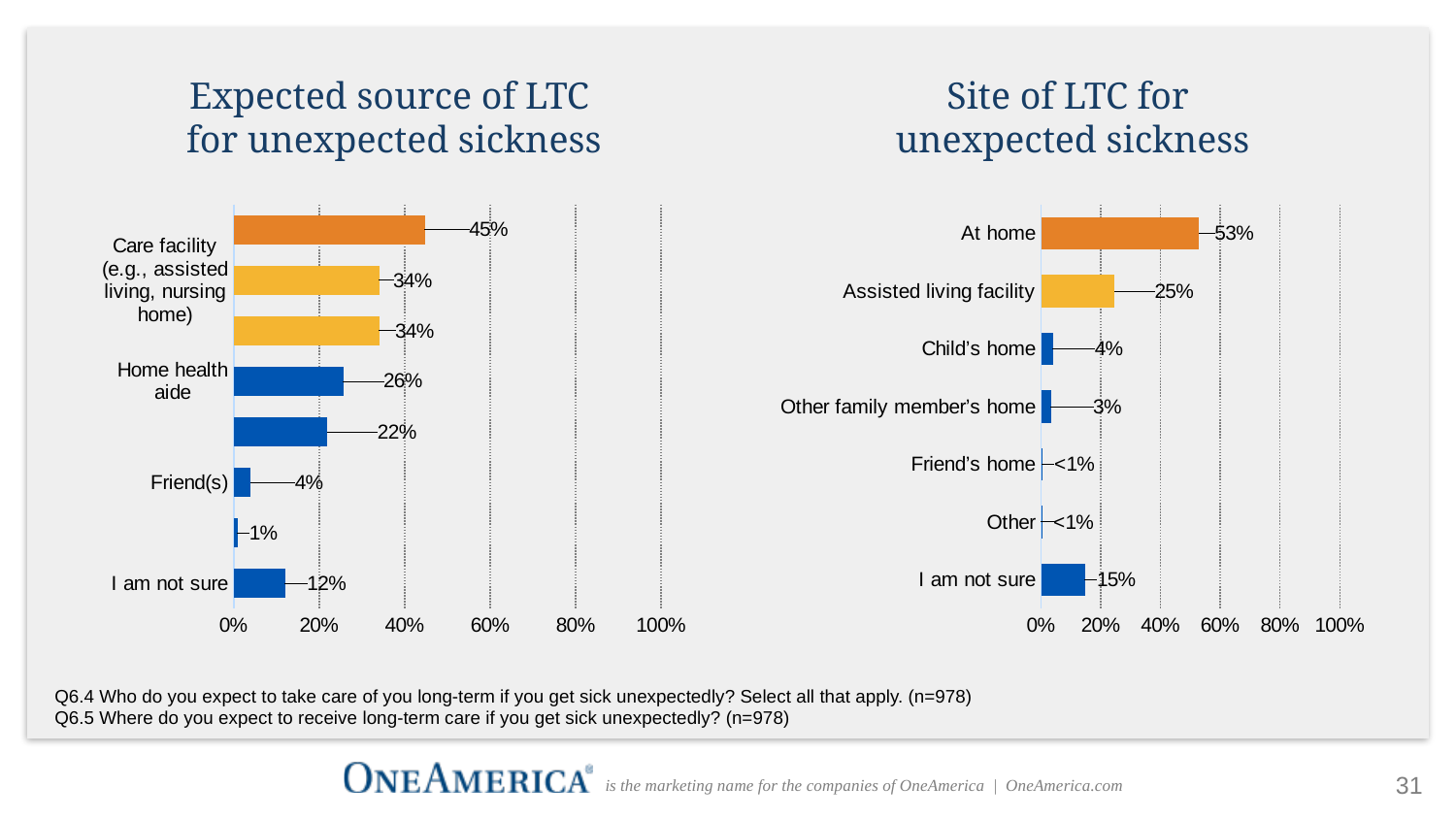
In the 'Expected source of LTC for unexpected sickness' chart, what is the value for Home health aide? 26% In the 'Site of LTC for unexpected sickness' chart, what is the difference between At home and Assisted living facility? 28% In the 'Expected source of LTC for unexpected sickness' chart, what is the difference between Home health aide and I am not sure? 14% In the 'Site of LTC for unexpected sickness' chart, which category has the highest value? At home In the 'Site of LTC for unexpected sickness' chart, what is the value for At home? 53% In the 'Expected source of LTC for unexpected sickness' chart, what is the value for Friend(s)? 4% In the 'Expected source of LTC for unexpected sickness' chart, what is the value for Care facility (e.g., assisted living, nursing home)? 34% In the 'Site of LTC for unexpected sickness' chart, what is the value for Assisted living facility? 25% What kind of chart is the 'Site of LTC for unexpected sickness' chart? Bar chart In the 'Site of LTC for unexpected sickness' chart, which is larger: Child's home or Other family member's home? Child's home In the 'Site of LTC for unexpected sickness' chart, how many categories are shown? 7 In the 'Site of LTC for unexpected sickness' chart, what is the value for I am not sure? 15%